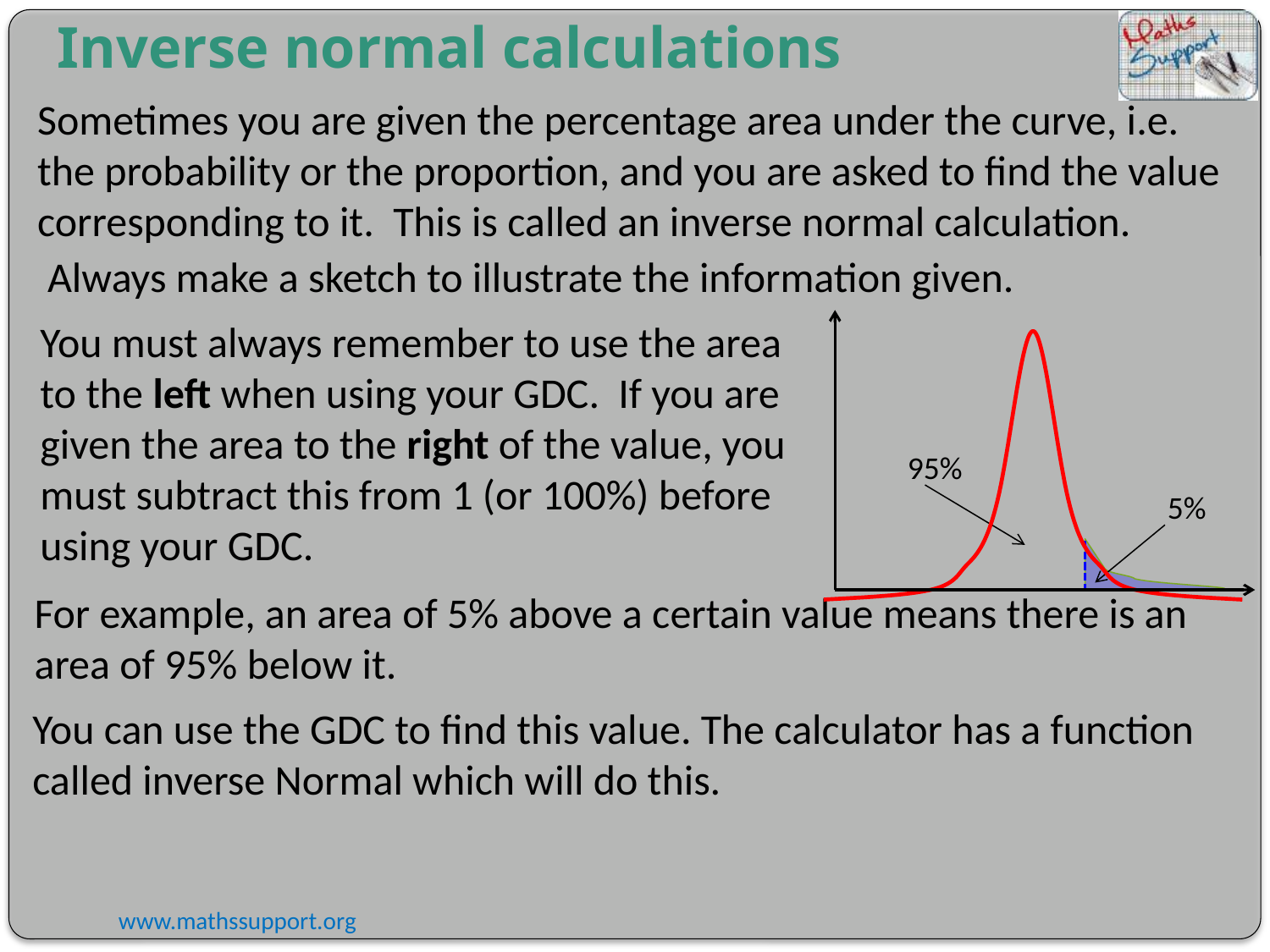
How many percentage labels are shown on the sketch on the right of the slide? 2 In the sketch on the right of the slide, what colour is the curve drawn in? red In the sketch on the right of the slide, is the 5% region shaded on the left or the right tail of the curve? the right tail In the sketch on the right of the slide, what percentage is labelled for the shaded area to the right of the dashed line? 5% What kind of curve is sketched on the right of the slide? a normal distribution (bell) curve In the sketch on the right of the slide, what percentage is labelled for the area under the curve to the left of the dashed line? 95% In the sketch on the right of the slide, which labelled area is larger, the one to the left of the dashed line or the one to the right? the one to the left (95%) In the sketch on the right of the slide, what do the two labelled percentage areas add up to? 100%